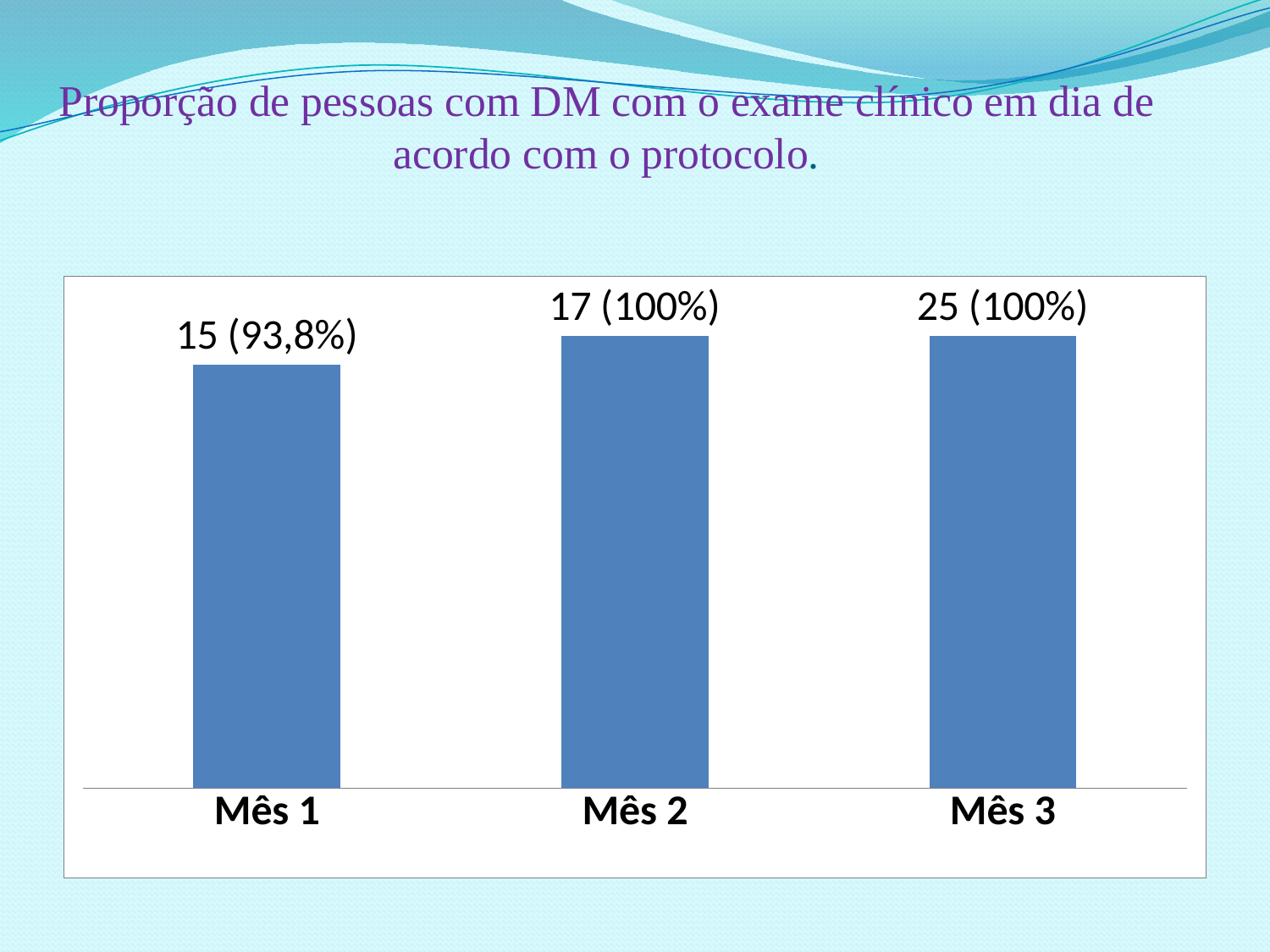
What percentage is shown for Mês 1? 93,8% Which month has the highest count of people in its data label? Mês 3 How many people are counted in the label for Mês 3? 25 What is the difference in percentage between Mês 2 and Mês 1? 6,2% How many categories (months) are shown on the x axis? 3 What is the data label shown for Mês 2? 17 (100%) What is the difference between the counts for Mês 3 and Mês 2? 8 Which bar is taller, Mês 1 or Mês 2? Mês 2 Which month has the lowest bar? Mês 1 What kind of chart is shown on the slide? Bar chart What is the data label shown for Mês 1? 15 (93,8%) What is the data label shown for Mês 3? 25 (100%)